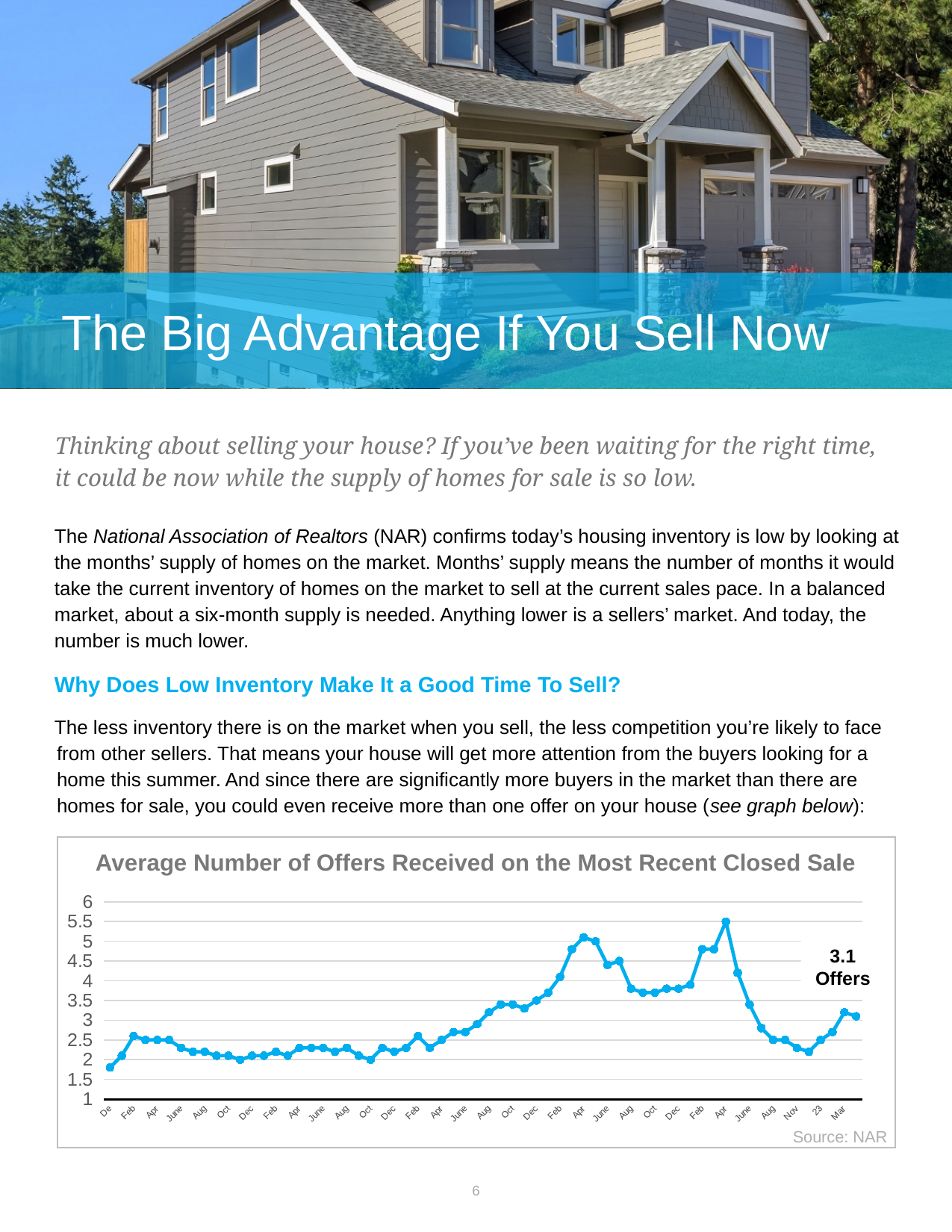
Is the value at the first point of the line greater or less than 2? less What value is labeled at the final point of the line? 3.1 Offers Is the value at the first peak (around Apr, before the dip) greater or less than 4.5? greater What is the title of the chart? Average Number of Offers Received on the Most Recent Closed Sale Is the value at the final point of the line greater or less than 3.5? less Does the line end higher or lower than where it starts? higher How many lines are plotted on the chart? 1 What is the highest value shown on the vertical axis? 6 What kind of chart is shown on the slide? line chart